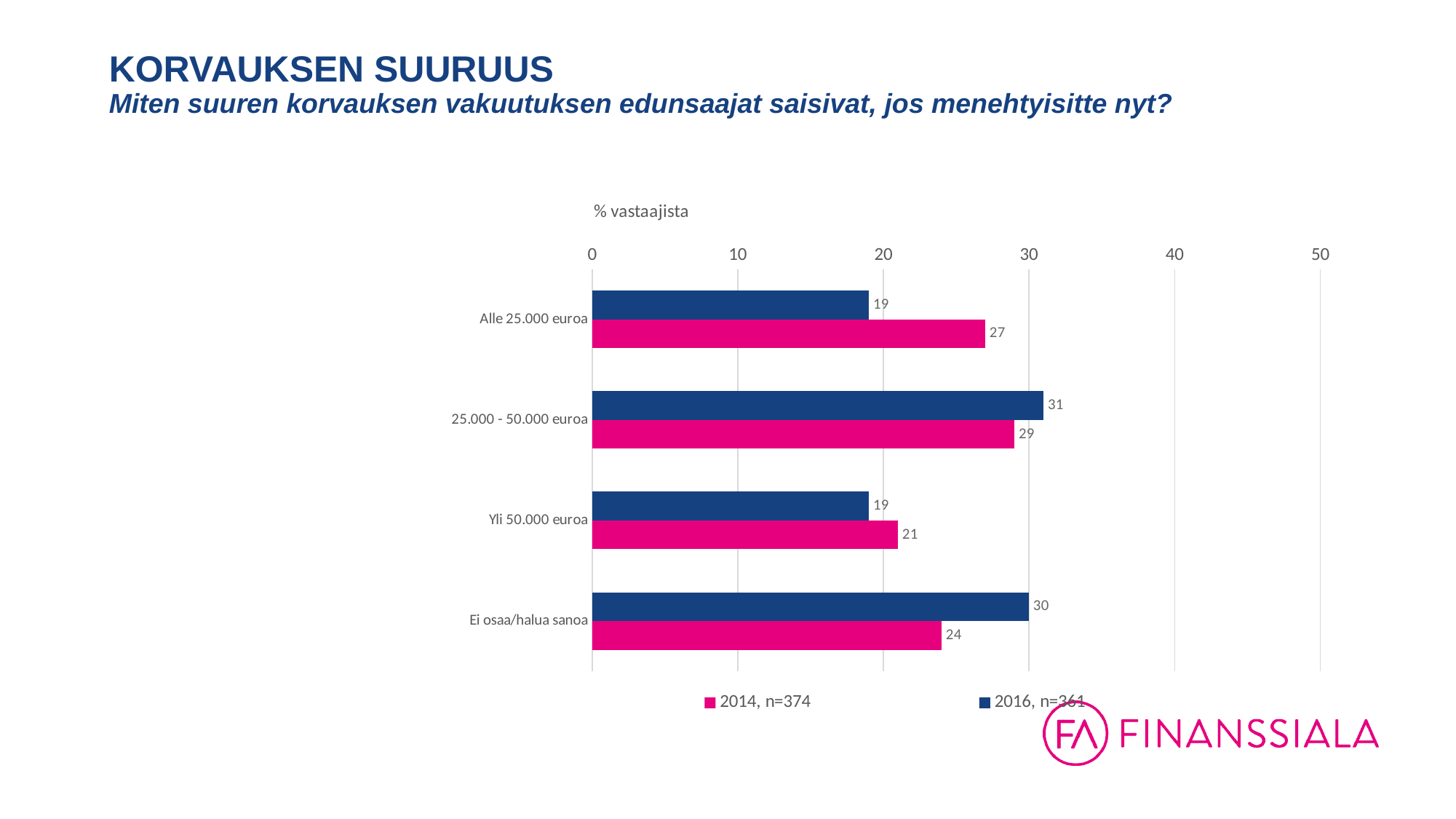
What is the difference between the 2016 and 2014 values for "Ei osaa/halua sanoa"? 6 How many series does the legend list? 2 Which category has the lowest 2014 value? Yli 50.000 euroa What is the 2016 value for "Ei osaa/halua sanoa"? 30 How many categories are shown on the chart? 4 What kind of chart is shown on the slide? Bar chart What is the 2016 value for "25.000 - 50.000 euroa"? 31 What is the 2014 value for "Alle 25.000 euroa"? 27 Is the 2014 value for "25.000 - 50.000 euroa" greater or less than 20? greater For "Yli 50.000 euroa", which year has the larger value, 2014 or 2016? 2014 What is the difference between the 2014 and 2016 values for "Alle 25.000 euroa"? 8 Which category has the highest 2016 value? 25.000 - 50.000 euroa